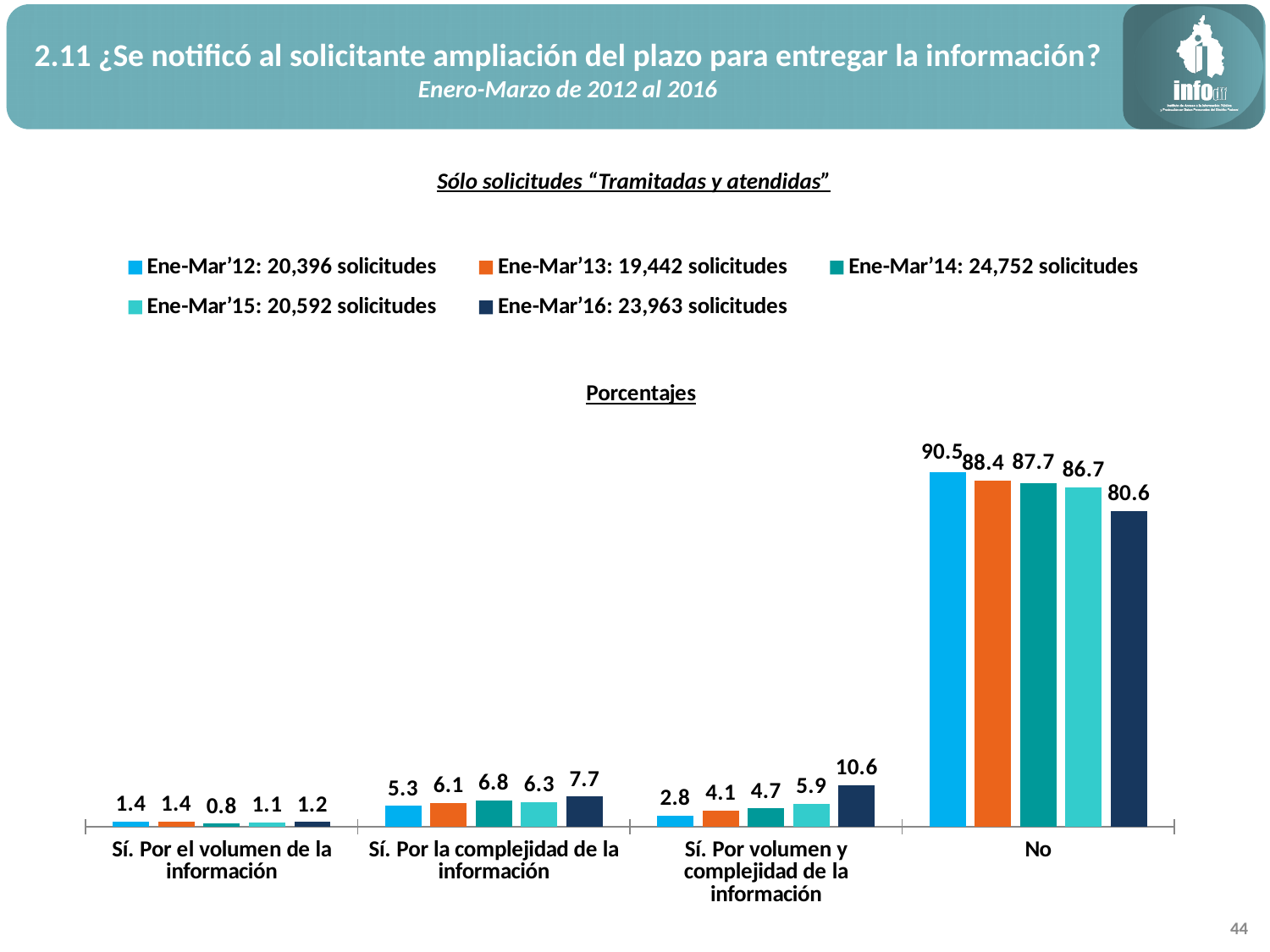
What is the difference between the Ene-Mar'12 and Ene-Mar'16 values in the 'No' category? 9.9 In the 'No' category, do the values rise or fall from Ene-Mar'12 to Ene-Mar'16? Fall What is the value for Ene-Mar'12 in the 'Sí. Por volumen y complejidad de la información' category? 2.8 Which is larger in the 'Sí. Por volumen y complejidad de la información' category: Ene-Mar'15 or Ene-Mar'16? Ene-Mar'16 What kind of chart is shown on the slide? Bar chart How many solicitudes does the legend give for Ene-Mar'14? 24,752 Which series has the lowest value in the 'Sí. Por el volumen de la información' category? Ene-Mar'14: 24,752 solicitudes Which series has the highest value in the 'No' category? Ene-Mar'12: 20,396 solicitudes What is the value for Ene-Mar'16 in the 'No' category? 80.6 How many categories are shown on the x axis? 4 How many series does the legend list? 5 What is the value for Ene-Mar'14 in the 'Sí. Por la complejidad de la información' category? 6.8